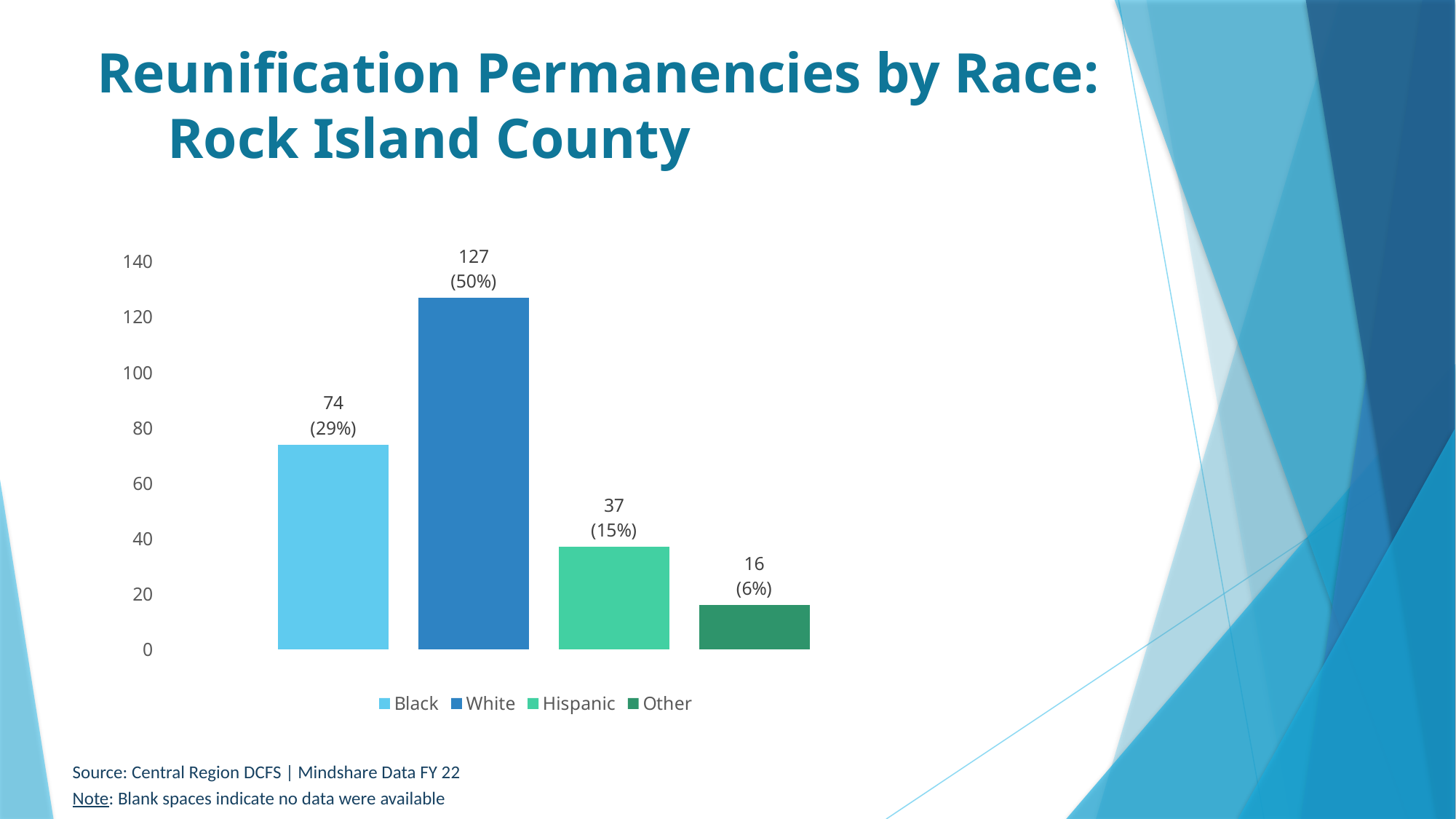
What is the number of reunification permanencies for Black? 74 Which race category has the lowest number of reunification permanencies? Other Is the value for Black greater or less than 80? less What is the value shown for Other? 16 What percentage is shown for Hispanic? 15% What kind of chart is shown on the slide? Bar chart What is the source cited for the chart data? Central Region DCFS | Mindshare Data FY 22 Which race category has the highest number of reunification permanencies? White What is the number of reunification permanencies for White? 127 What is the difference between the White and Black values? 53 Which is larger, the value for Hispanic or the value for Other? Hispanic How many race categories are plotted in the chart? 4